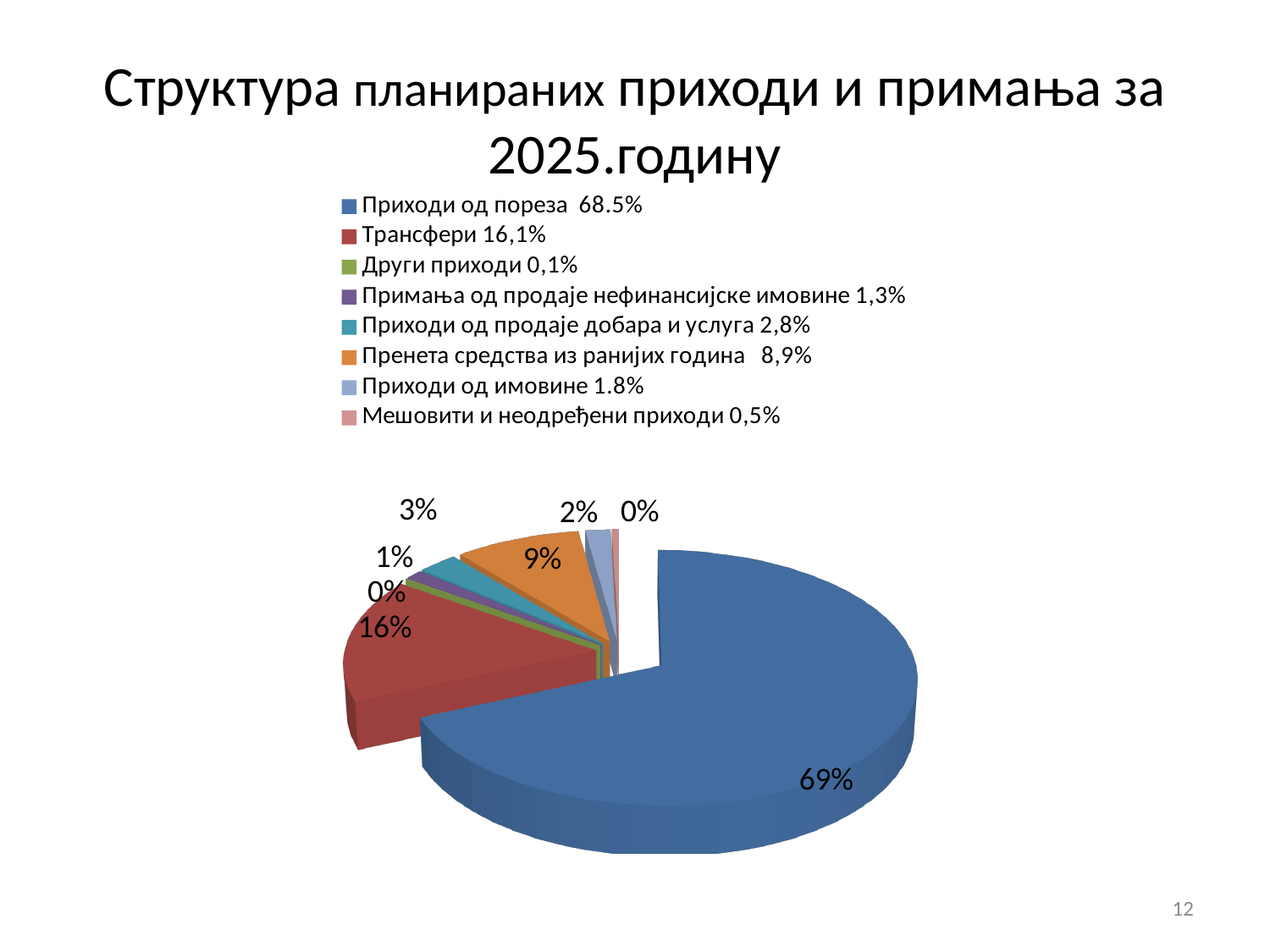
Which is larger, the Трансфери slice or the Пренета средства из ранијих година slice? Трансфери What share of the pie does Приходи од пореза take according to its data label? 69% How many entries does the legend list? 8 What is the title of the slide containing the chart? Структура планираних приходи и примања за 2025.годину Which category has the largest slice of the pie? Приходи од пореза Using the data labels, what is the difference between the Приходи од пореза slice and the Трансфери slice? 53% How many slices does the pie chart have? 8 What kind of chart is shown on the slide? pie chart What percentage is shown on the data label of the Трансфери slice? 16% Which category has the smallest share according to the legend? Други приходи What percentage is shown on the data label of the Пренета средства из ранијих година slice? 9% What percentage does the legend give for Приходи од продаје добара и услуга? 2,8%